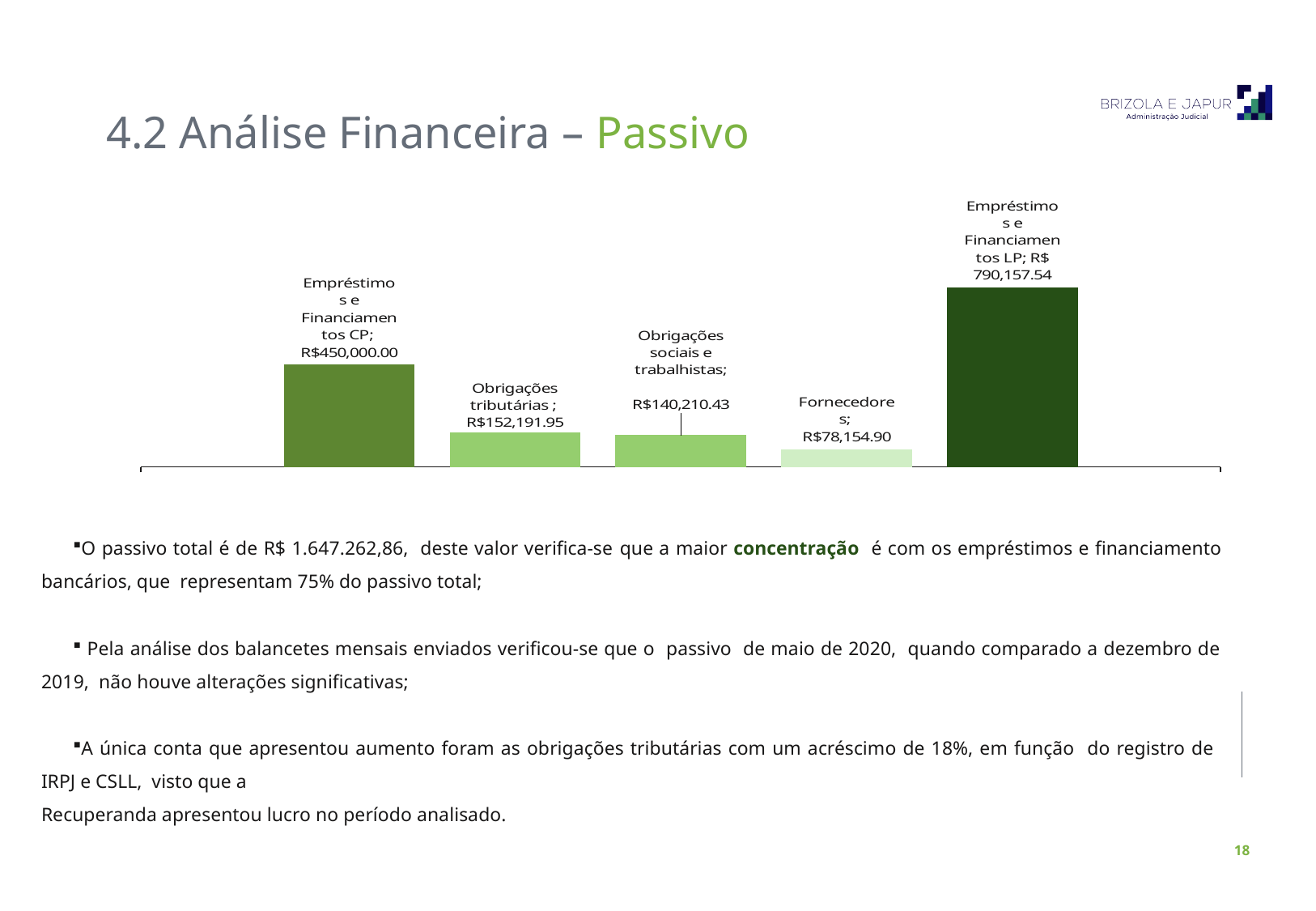
What type of chart is shown on the slide? Bar chart What is the value for Fornecedores? R$78,154.90 What is the difference between Obrigações tributárias and Obrigações sociais e trabalhistas? R$11,981.52 Which category has the highest value? Empréstimos e Financiamentos LP How many categories are shown in the chart? 5 What is the value for Empréstimos e Financiamentos LP? R$ 790,157.54 What is the value for Empréstimos e Financiamentos CP? R$450,000.00 What is the value for Obrigações sociais e trabalhistas? R$140,210.43 Which is larger, Empréstimos e Financiamentos CP or Fornecedores? Empréstimos e Financiamentos CP Which category has the lowest value? Fornecedores What is the difference between Empréstimos e Financiamentos LP and Empréstimos e Financiamentos CP? R$340,157.54 What is the value for Obrigações tributárias? R$152,191.95